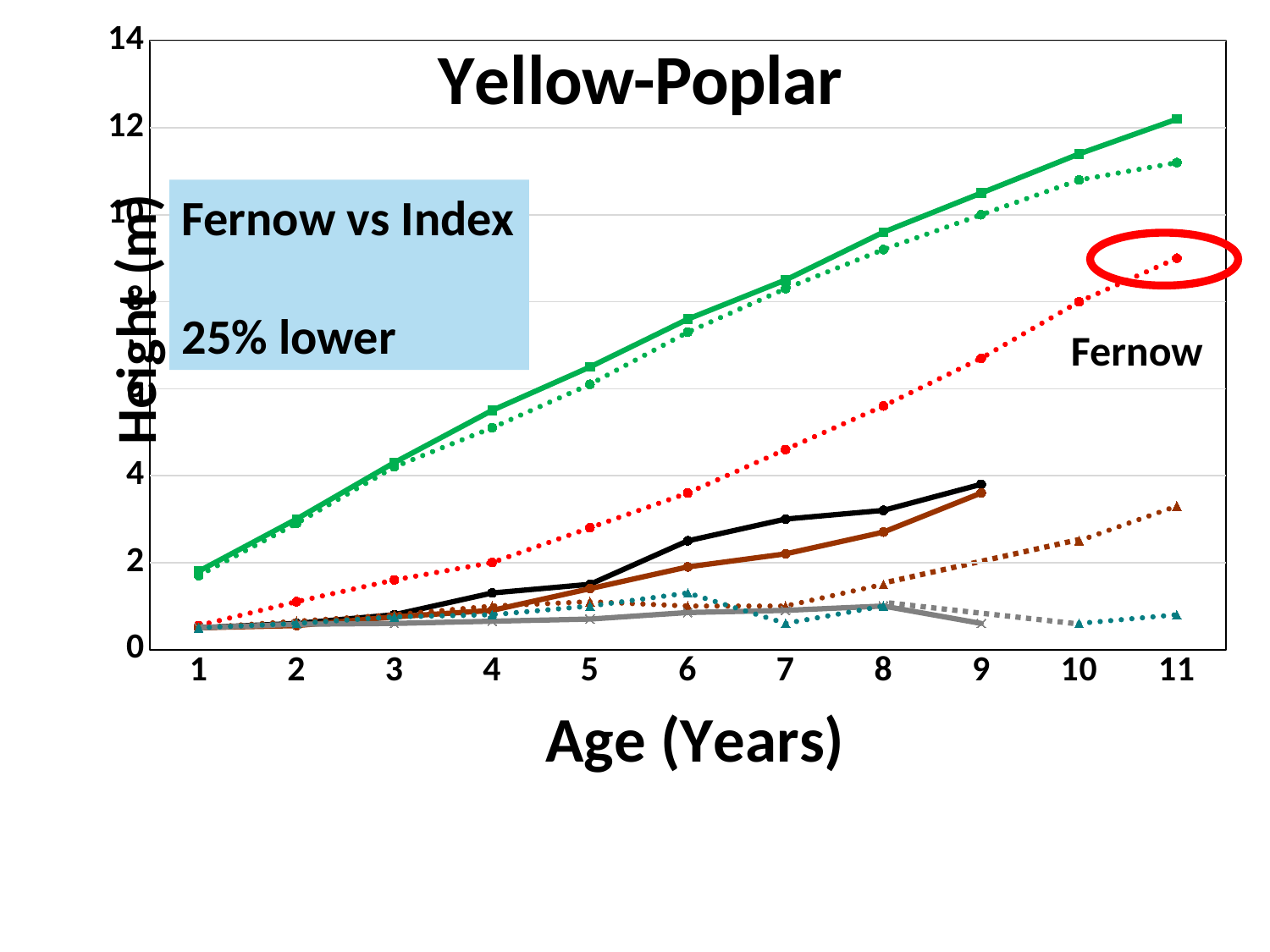
Is the Fernow value at age 5 greater or less than 4? less Is the value of the solid green line at age 9 greater or less than 10? greater Is the Fernow value at age 11 greater or less than 8? greater Does the Fernow line rise or fall as age increases? Rises How many age values are shown along the x axis? 11 At age 11, which is larger: the solid green line or the Fernow line? The solid green line What is the label of the x axis? Age (Years) What kind of chart is shown on the slide? Line chart What is the title of the chart? Yellow-Poplar